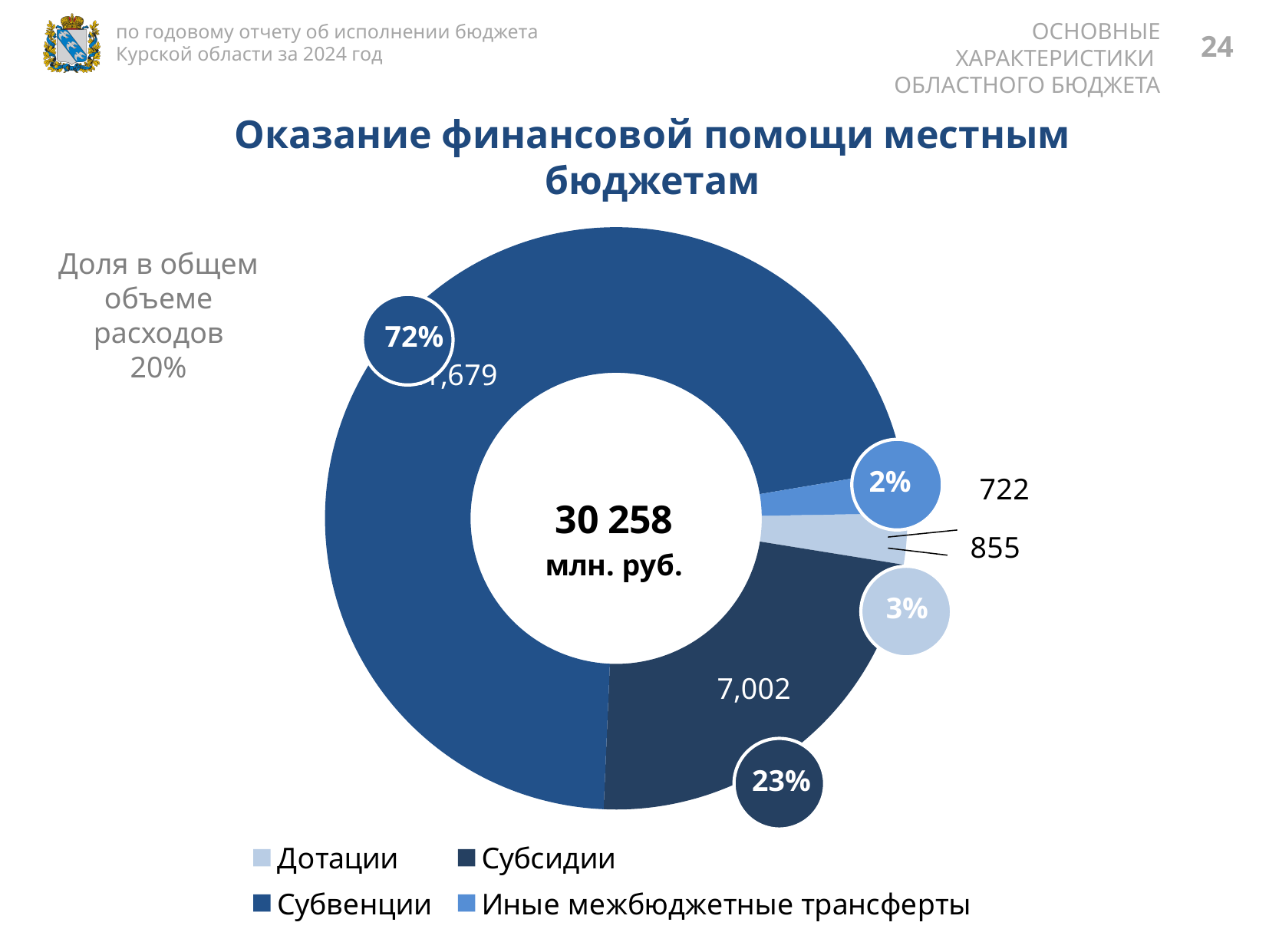
What is the value shown for Субсидии? 7,002 What share of the total do Субсидии make up? 23% Which is larger, the value for Субсидии or the value for Дотации? Субсидии What is the value shown for Дотации? 855 Which category has the largest share of the chart? Субвенции What is the difference between the values for Дотации and Иные межбюджетные трансферты? 133 Which category has the smallest share of the chart? Иные межбюджетные трансферты What share of the total do Субвенции make up? 72% What total amount is shown in the centre of the chart? 30 258 млн. руб. What kind of chart is shown on the slide? Doughnut (pie) chart How many categories are shown in the chart? 4 What is the value shown for Иные межбюджетные трансферты? 722